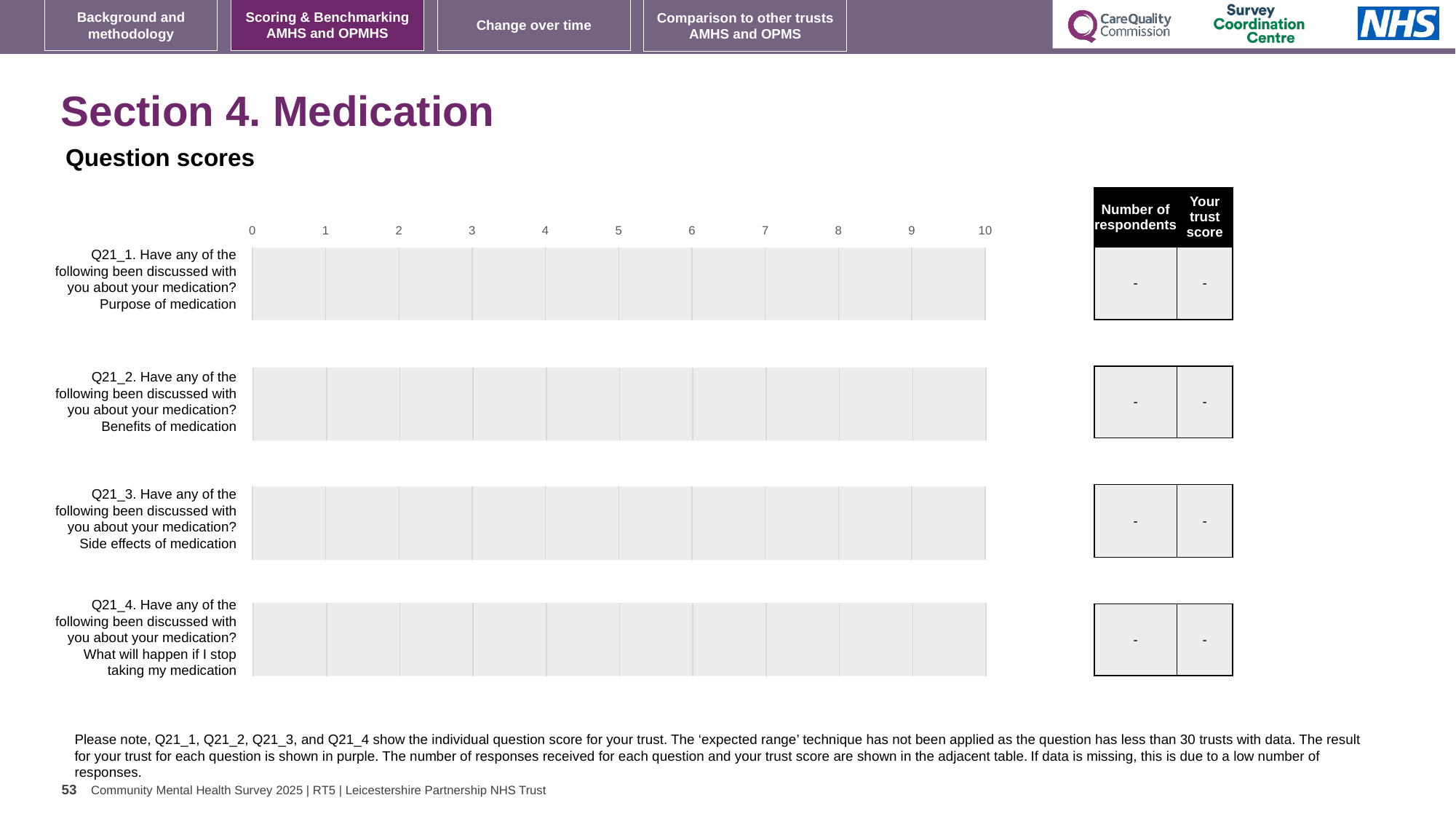
How many question rows (categories) are shown in the chart area on the slide? 4 What is the lowest value shown on the horizontal axis of the charts? 0 What value is shown in the 'Number of respondents' column for Q21_4 (What will happen if I stop taking my medication)? - What value is shown in the 'Your trust score' column for Q21_1 (Purpose of medication)? - What value is shown in the 'Your trust score' column for Q21_3 (Side effects of medication)? - What kind of chart is used on the slide for the question scores? Bar chart Which question label corresponds to the second chart row on the slide? Q21_2. Have any of the following been discussed with you about your medication? Benefits of medication What is the highest value shown on the horizontal axis of the charts? 10